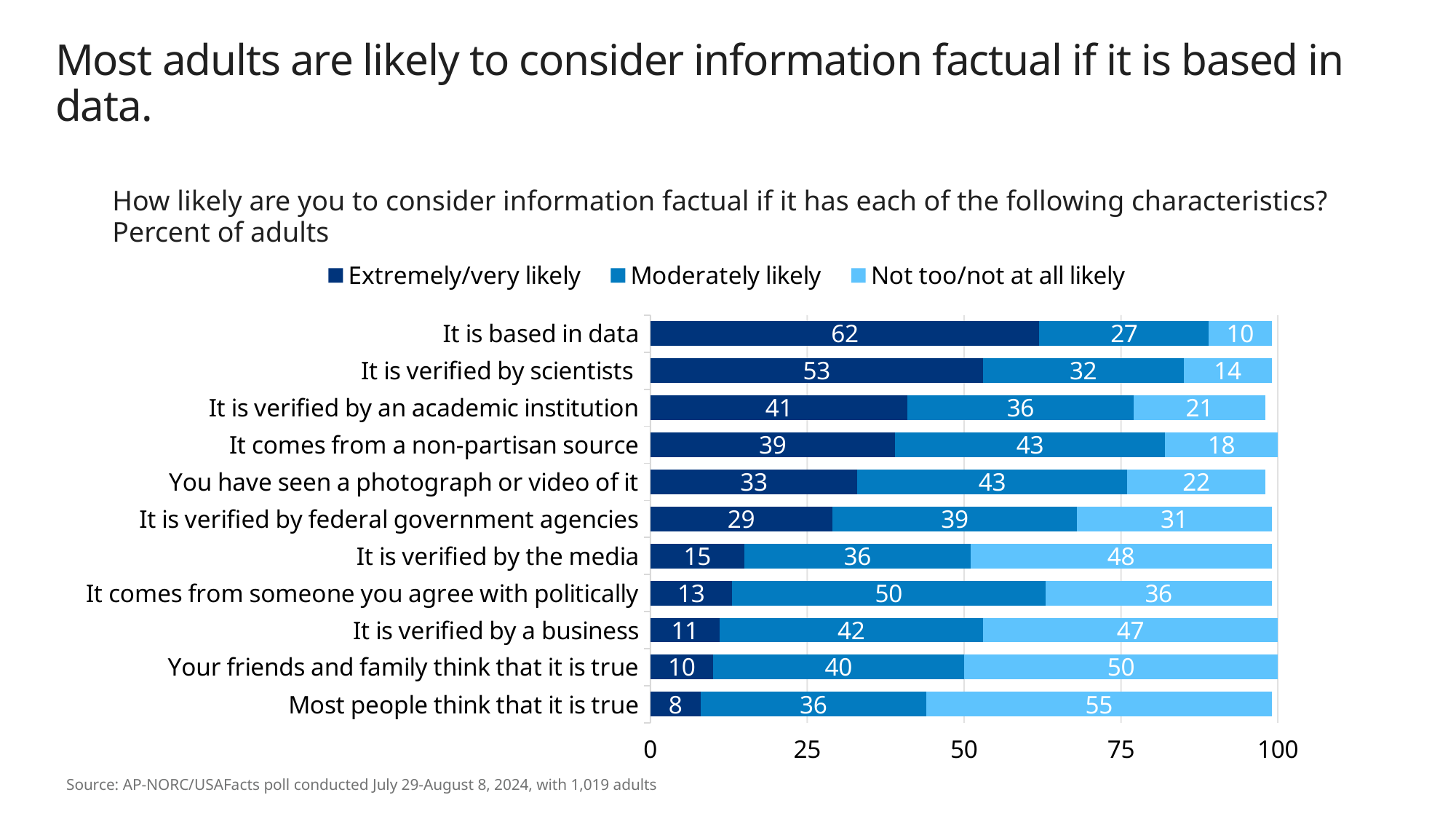
Which series is shown in the darkest blue colour? Extremely/very likely What is the difference between the 'Extremely/very likely' values for 'It is based in data' and 'It is verified by scientists'? 9 How many characteristics (categories) are shown in the chart? 11 What percentage of adults are extremely/very likely to consider information factual if it is based in data? 62 What is the 'Not too/not at all likely' value for 'It is verified by the media'? 48 What is the 'Moderately likely' value for 'It comes from someone you agree with politically'? 50 Which characteristic has the highest 'Extremely/very likely' value? It is based in data Which has a larger 'Not too/not at all likely' value: 'It is verified by a business' or 'It is verified by federal government agencies'? It is verified by a business What kind of chart is shown on the slide? Stacked bar chart What is the total of the stacked bar for 'It is verified by scientists'? 99 Which characteristic has the lowest 'Extremely/very likely' value? Most people think that it is true How many series does the legend list? 3